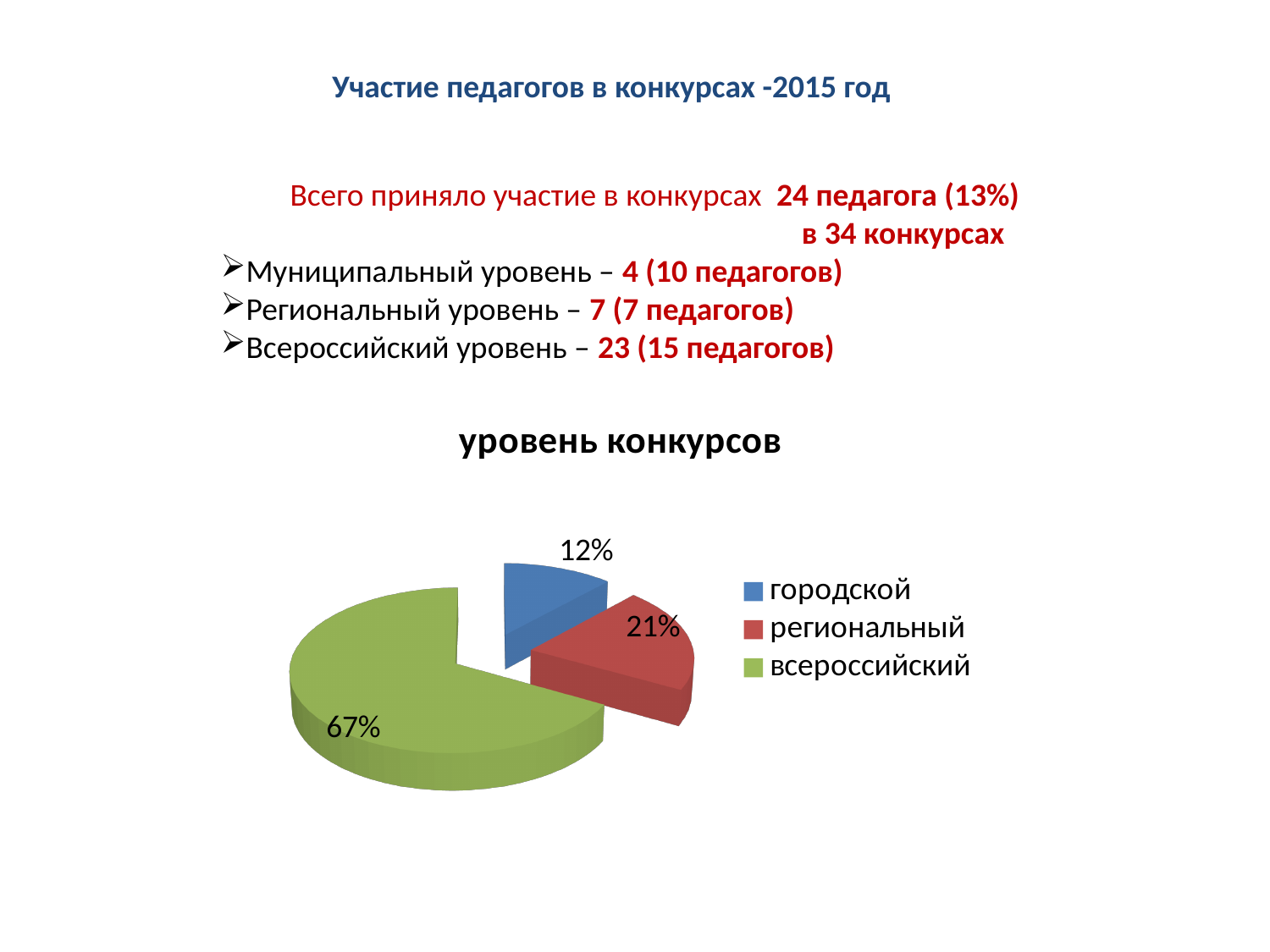
What type of chart is shown under the title "уровень конкурсов"? pie chart What percentage is shown for the "городской" slice? 12% Which category has the largest share of the pie? всероссийский Which slice is larger, "региональный" or "городской"? региональный What percentage is shown for the "всероссийский" slice? 67% How many entries does the legend list? 3 What colour is the "всероссийский" slice? green What is the title of the chart? уровень конкурсов What percentage is shown for the "региональный" slice? 21% What is the difference in percentage points between the "всероссийский" and "региональный" slices? 46 Which category has the smallest share of the pie? городской How many slices does the pie chart have? 3